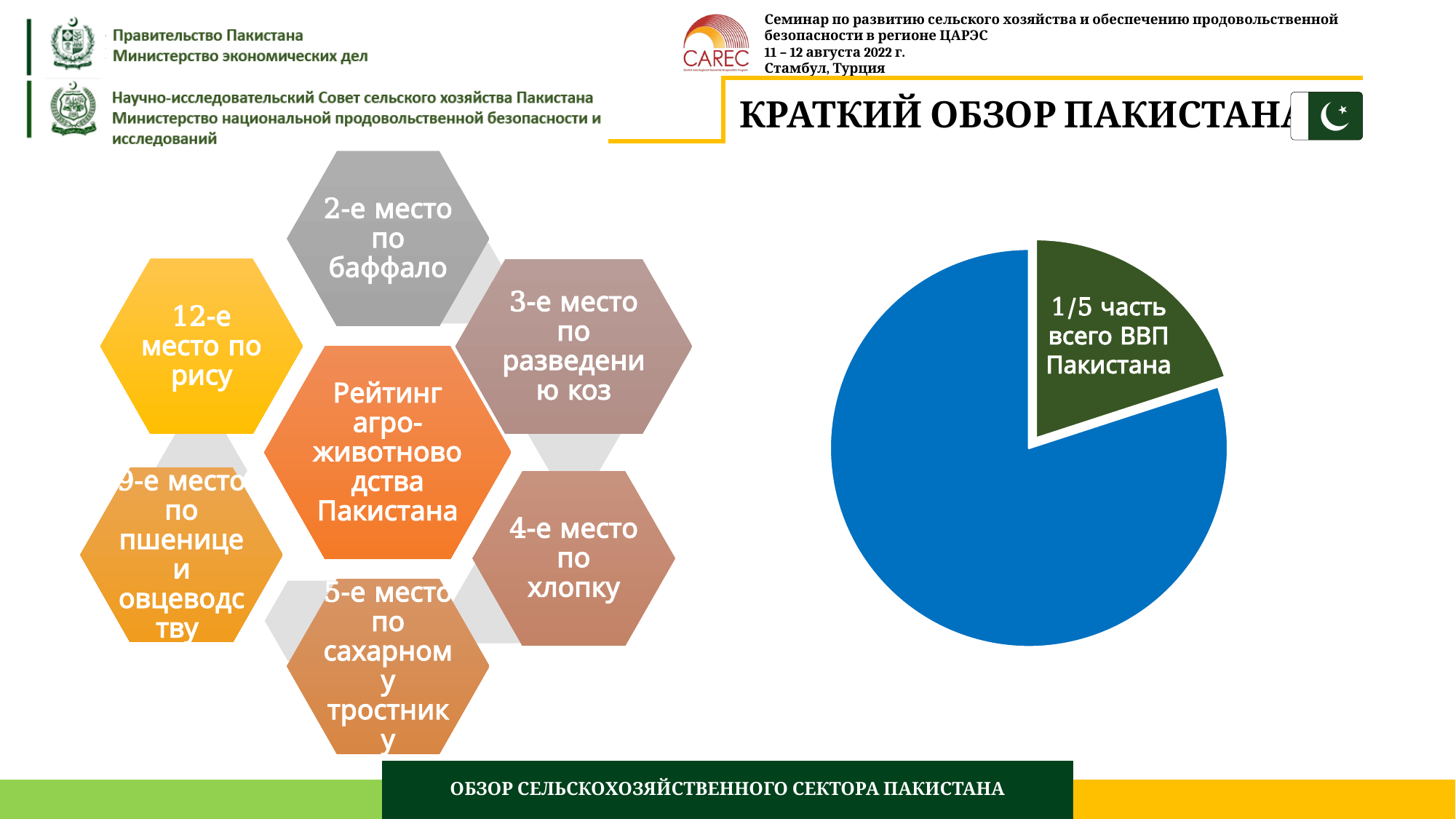
What does the label on the green slice of the pie chart say? 1/5 часть всего ВВП Пакистана Which slice of the pie chart is the smallest? the green slice (1/5 часть всего ВВП Пакистана) What colour is the slice of the pie chart that carries the label about Pakistan's GDP? green How many slices does the pie chart on the right have? 2 Which slice of the pie chart is larger, the blue one or the green one? blue Is the green slice of the pie chart greater or less than half of the pie? less According to the label on the pie chart, what share of Pakistan's total GDP does the green slice represent? 1/5 What kind of chart is shown on the right side of the slide? pie chart